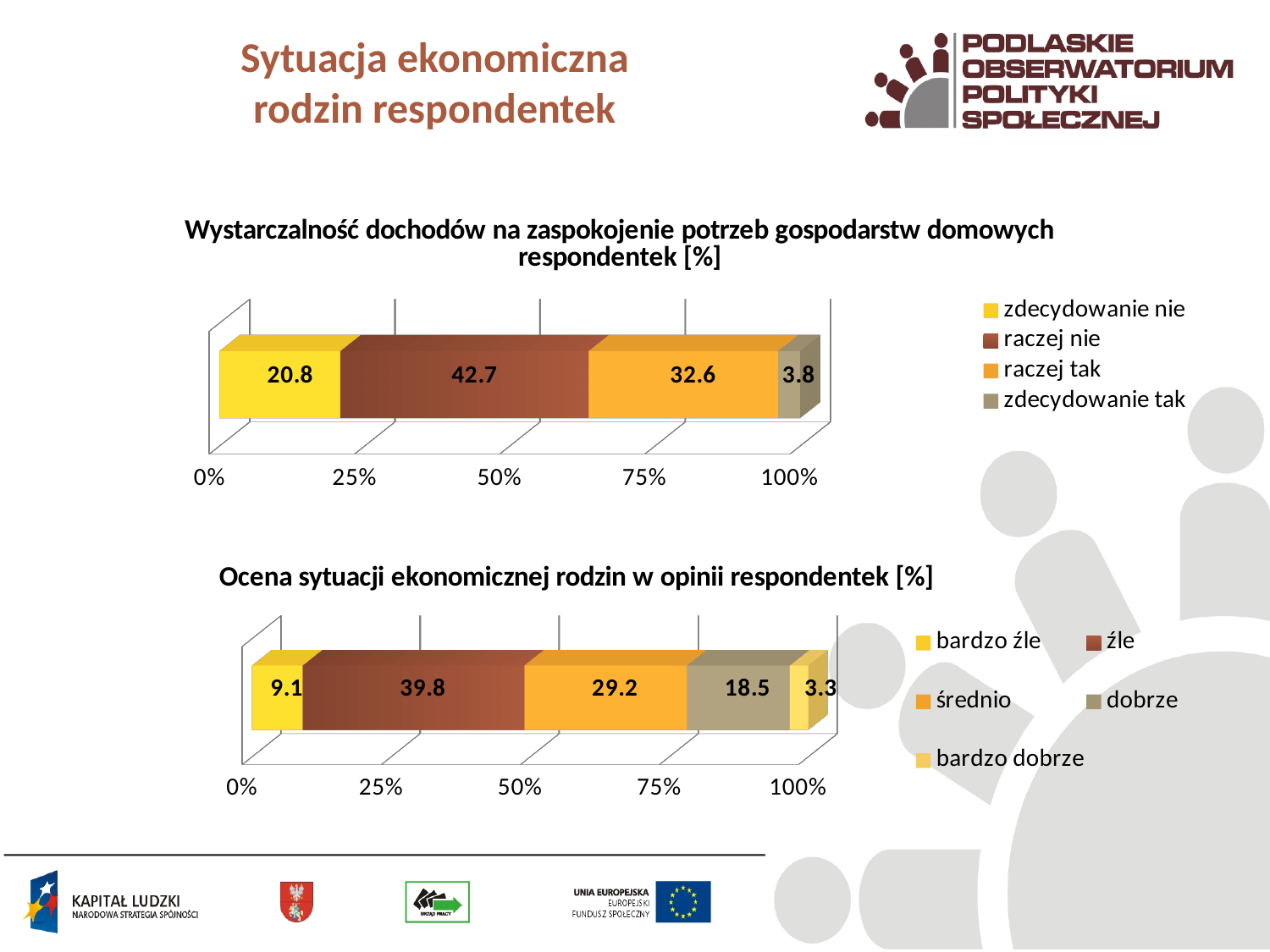
In the bottom chart (Ocena sytuacji ekonomicznej), what is the value for 'dobrze'? 18.5 In the top chart (Wystarczalność dochodów), what is the difference between 'raczej nie' and 'raczej tak'? 10.1 In the bottom chart (Ocena sytuacji ekonomicznej), what is the value for 'średnio'? 29.2 What type of chart is the top chart (Wystarczalność dochodów)? stacked bar chart In the bottom chart (Ocena sytuacji ekonomicznej), what is the difference between 'źle' and 'bardzo źle'? 30.7 In the bottom chart (Ocena sytuacji ekonomicznej), how many series does the legend list? 5 In the top chart (Wystarczalność dochodów), how many series does the legend list? 4 In the bottom chart (Ocena sytuacji ekonomicznej), which is larger: 'bardzo źle' or 'dobrze'? dobrze In the top chart (Wystarczalność dochodów), which series has the highest value? raczej nie In the bottom chart (Ocena sytuacji ekonomicznej), which series has the lowest value? bardzo dobrze In the top chart (Wystarczalność dochodów), what is the value for 'zdecydowanie tak'? 3.8 In the top chart (Wystarczalność dochodów), what is the value for 'raczej nie'? 42.7